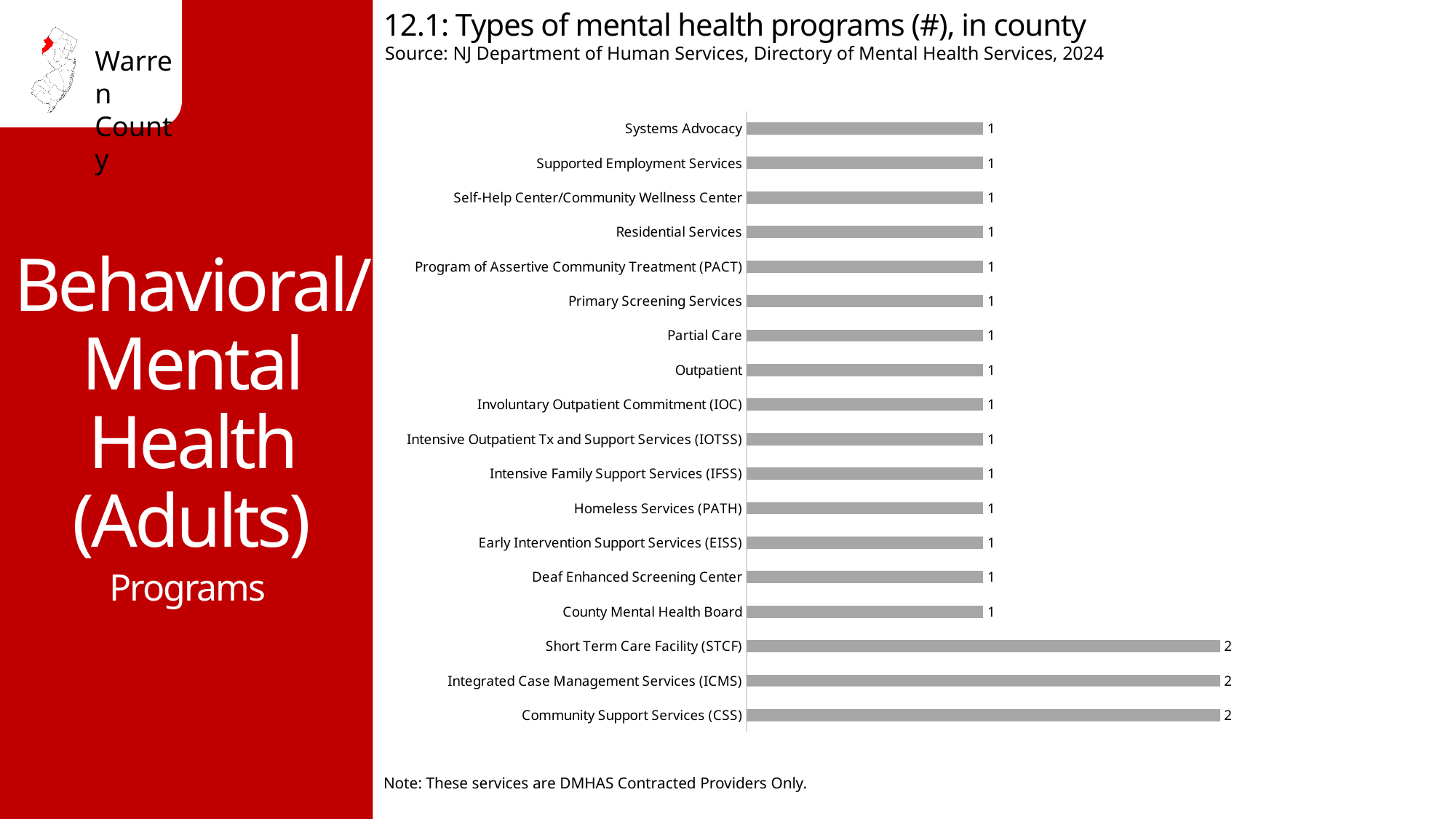
What colour are the bars in the chart? gray Which is larger, the value for Outpatient or the value for Community Support Services (CSS)? Community Support Services (CSS) What is the value for Short Term Care Facility (STCF)? 2 What kind of chart is shown on the slide? bar chart What is the title of the chart? 12.1: Types of mental health programs (#), in county What is the value for Partial Care? 1 What is the value for Community Support Services (CSS)? 2 How many program types have a value of 2? 3 What is the value for Integrated Case Management Services (ICMS)? 2 What is the difference between the value for Short Term Care Facility (STCF) and the value for Residential Services? 1 How many program types are listed in the chart? 18 What is the value for Homeless Services (PATH)? 1